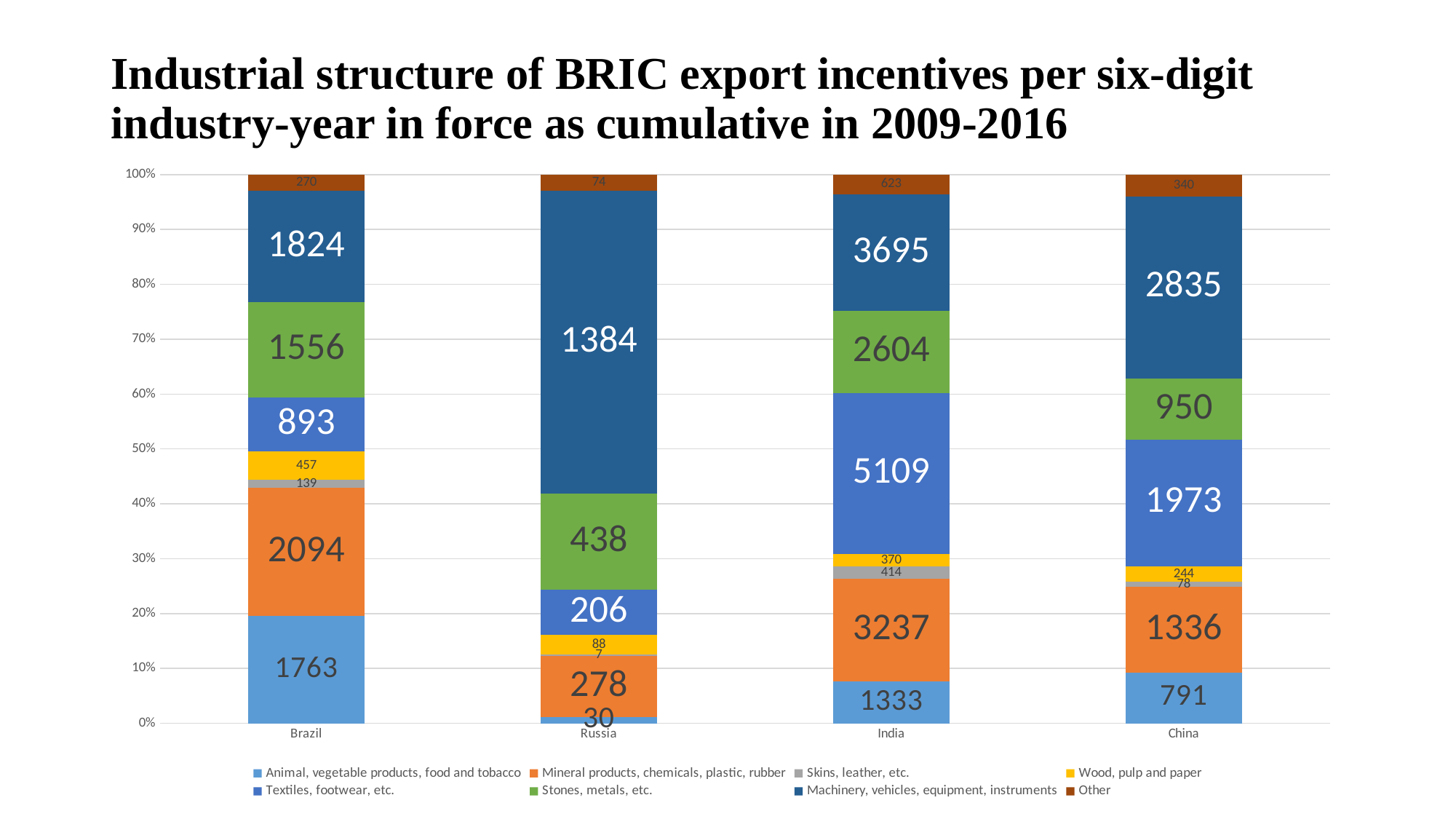
What is the difference between the Machinery, vehicles, equipment, instruments values for China and Brazil? 1011 What is the value for Textiles, footwear, etc. for China? 1973 Which country has the lowest value for Mineral products, chemicals, plastic, rubber? Russia Which country has the highest value for Textiles, footwear, etc.? India Which is larger for India: Stones, metals, etc. or Mineral products, chemicals, plastic, rubber? Mineral products, chemicals, plastic, rubber What is the value for Animal, vegetable products, food and tobacco for Brazil? 1763 What is the total of all segments in the Russia bar? 2505 What is the value for Machinery, vehicles, equipment, instruments for India? 3695 How many series does the legend list? 8 What is the value for Wood, pulp and paper for Russia? 88 What kind of chart is shown on the slide? Stacked bar chart How many countries are shown on the x axis? 4